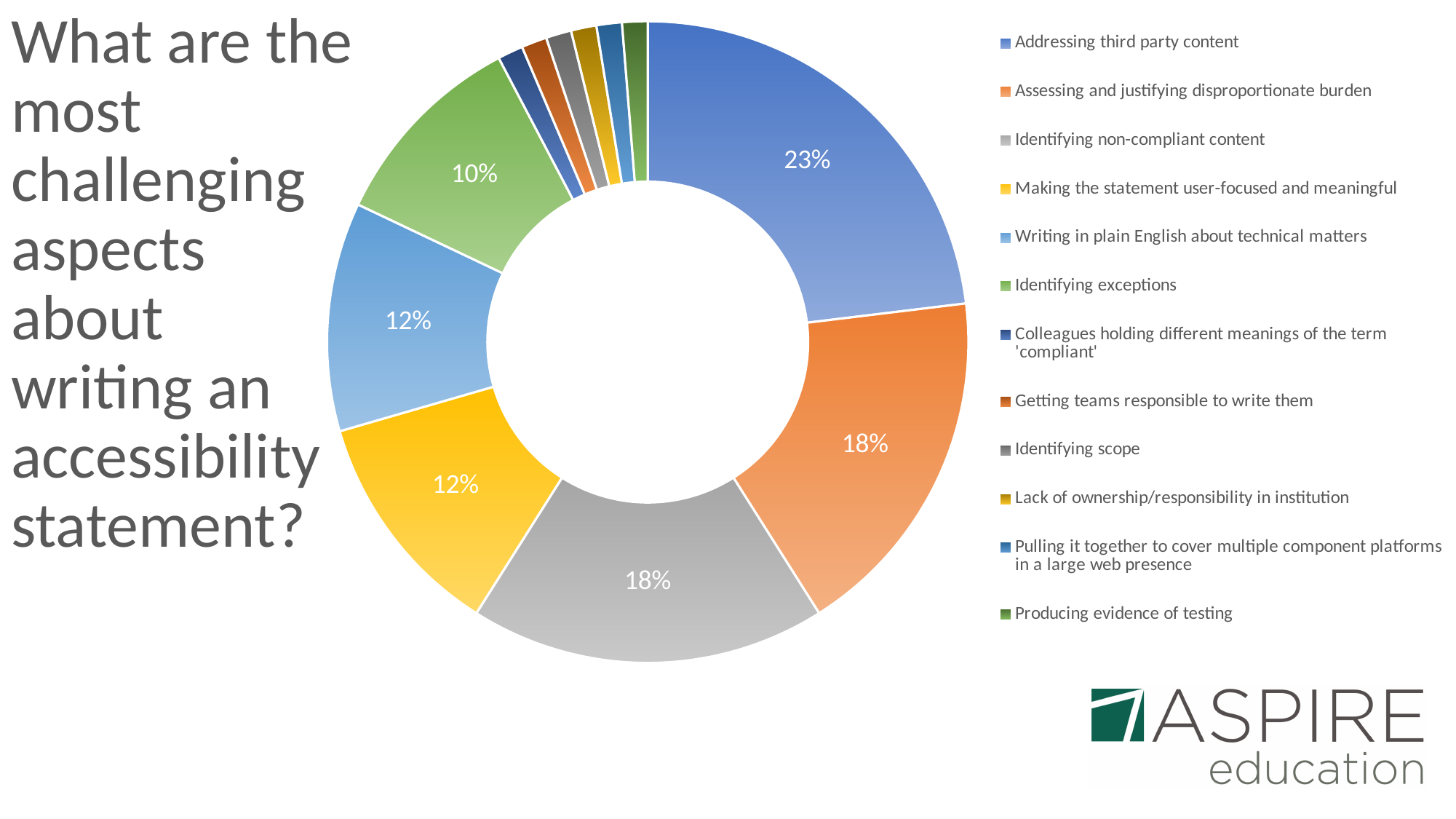
What kind of chart is shown on the slide? Doughnut (pie) chart What percentage is shown for 'Identifying non-compliant content'? 18% What percentage is shown for 'Writing in plain English about technical matters'? 12% What share of the chart is 'Addressing third party content'? 23% What percentage is shown for 'Assessing and justifying disproportionate burden'? 18% What percentage is shown for 'Identifying exceptions'? 10% What percentage is shown for 'Making the statement user-focused and meaningful'? 12% What is the difference in percentage points between 'Addressing third party content' and 'Identifying non-compliant content'? 5 What question does the slide title ask? What are the most challenging aspects about writing an accessibility statement? Which category has the largest share of the chart? Addressing third party content How many categories does the legend list? 12 Which is larger: the share for 'Identifying exceptions' or the share for 'Writing in plain English about technical matters'? Writing in plain English about technical matters